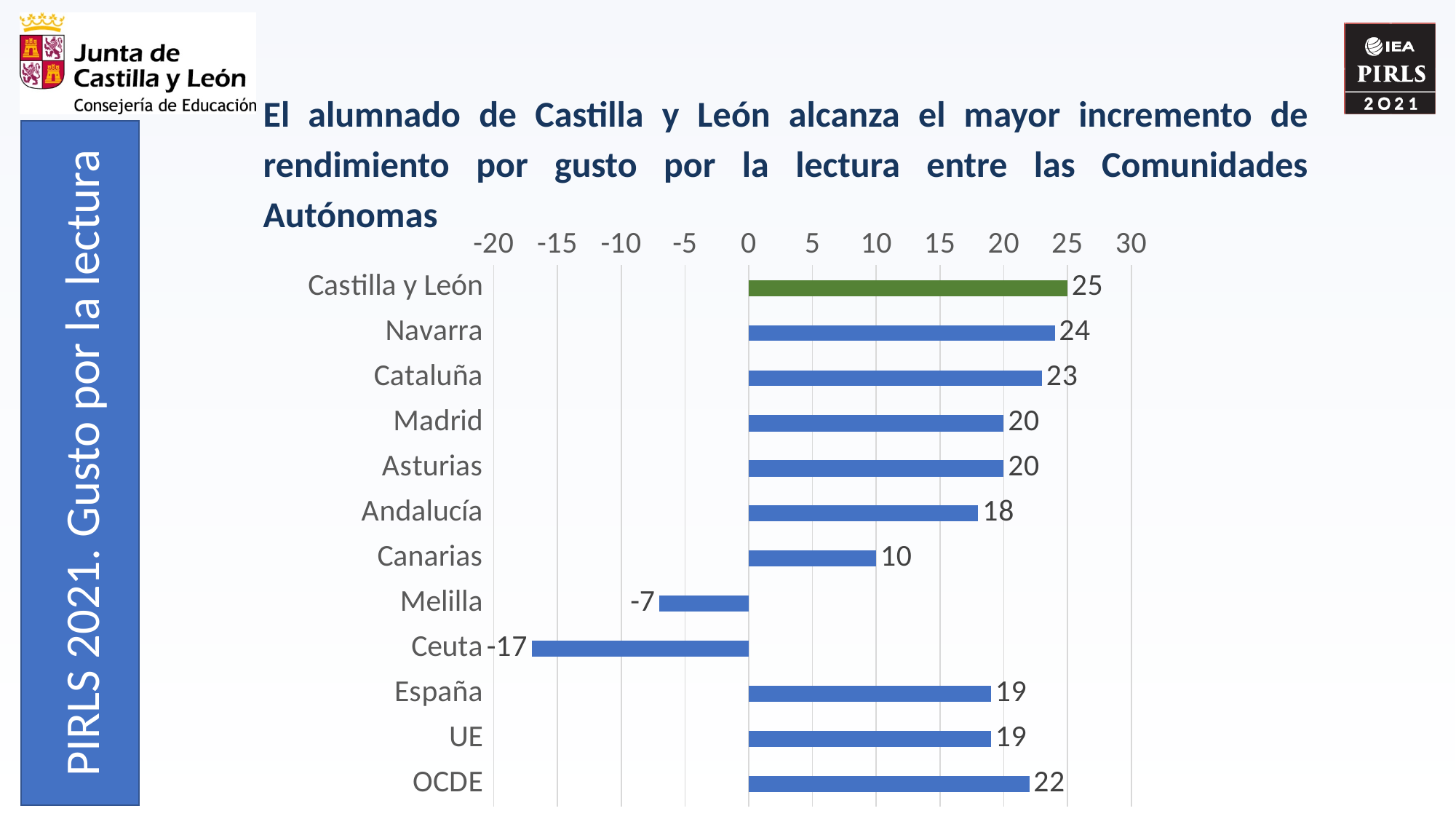
What is the value for OCDE? 22 What is the value for Ceuta? -17 What is the difference between the values for Melilla and Ceuta? 10 Which bar is coloured green rather than blue? Castilla y León What is the difference between the values for Castilla y León and España? 6 What is the value for Canarias? 10 Which category has the lowest value? Ceuta What is the value for Castilla y León? 25 How many categories are shown in the chart? 12 Which category has the highest value? Castilla y León What kind of chart is shown on the slide? Bar chart Which is larger, the value for Navarra or the value for Madrid? Navarra